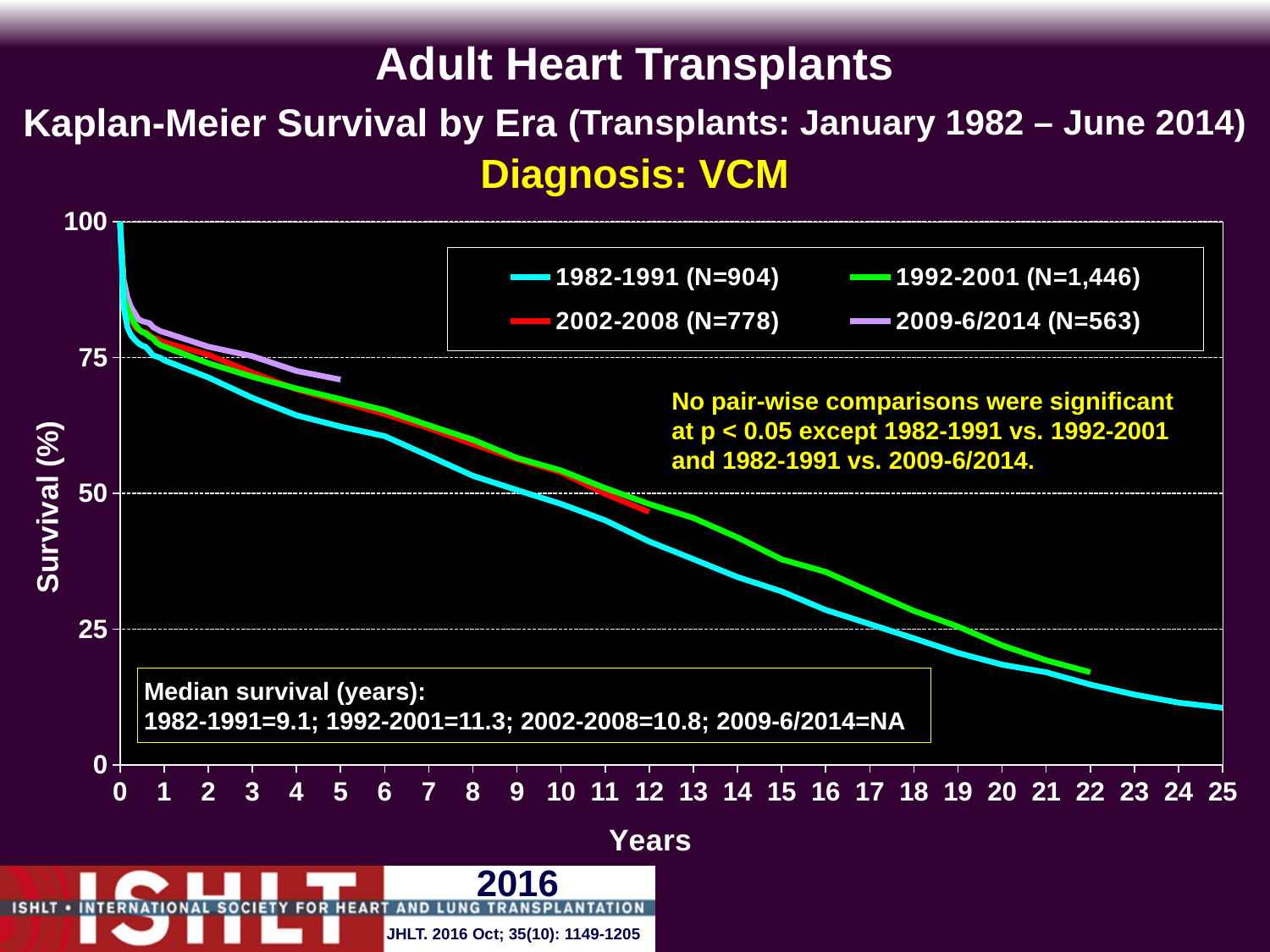
Is the survival for the 1992-2001 era at year 5 greater or less than 50? greater What is the N for the 1982-1991 era shown in the legend? 904 What is the difference in median survival (years) between the 1992-2001 and 1982-1991 eras? 2.2 What is the median survival for the 2009-6/2014 era? NA How many eras (series) does the legend list? 4 At year 15, which era has higher survival: 1992-2001 or 1982-1991? 1992-2001 Which era has the highest median survival? 1992-2001 What kind of chart is shown on the slide? line chart What is the median survival in years for the 2002-2008 era? 10.8 Is the survival for the 1982-1991 era at year 20 greater or less than 25? less Do the survival curves rise or fall as years increase? fall What is the median survival in years for the 1992-2001 era? 11.3